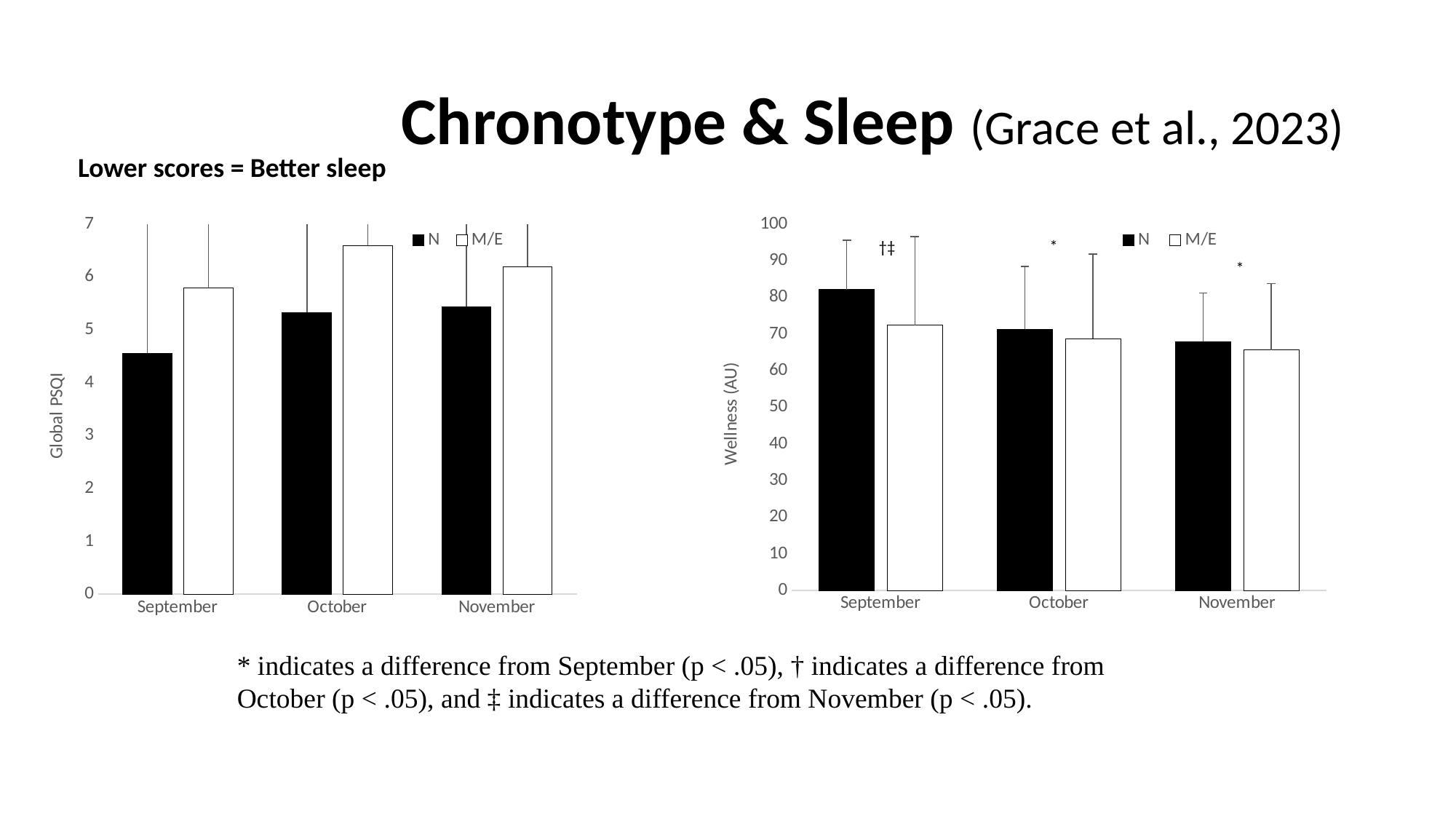
What kind of chart is the left chart (Global PSQI)? bar chart In the left chart (Global PSQI), is the value for M/E in October greater or less than 6? greater In the right chart (Wellness (AU)), is the value for M/E in November greater or less than 70? less How many series does the legend of the left chart (Global PSQI) list? 2 In the right chart (Wellness (AU)), do the N values rise or fall from September to November? fall In the right chart (Wellness (AU)), which is larger in September, N or M/E? N In the left chart (Global PSQI), which is larger in September, N or M/E? M/E How many months are shown on the x axis of the left chart (Global PSQI)? 3 In the left chart (Global PSQI), is the value for N in September greater or less than 5? less In the left chart (Global PSQI), in which month is the M/E value highest? October What is the y-axis label of the right chart? Wellness (AU)